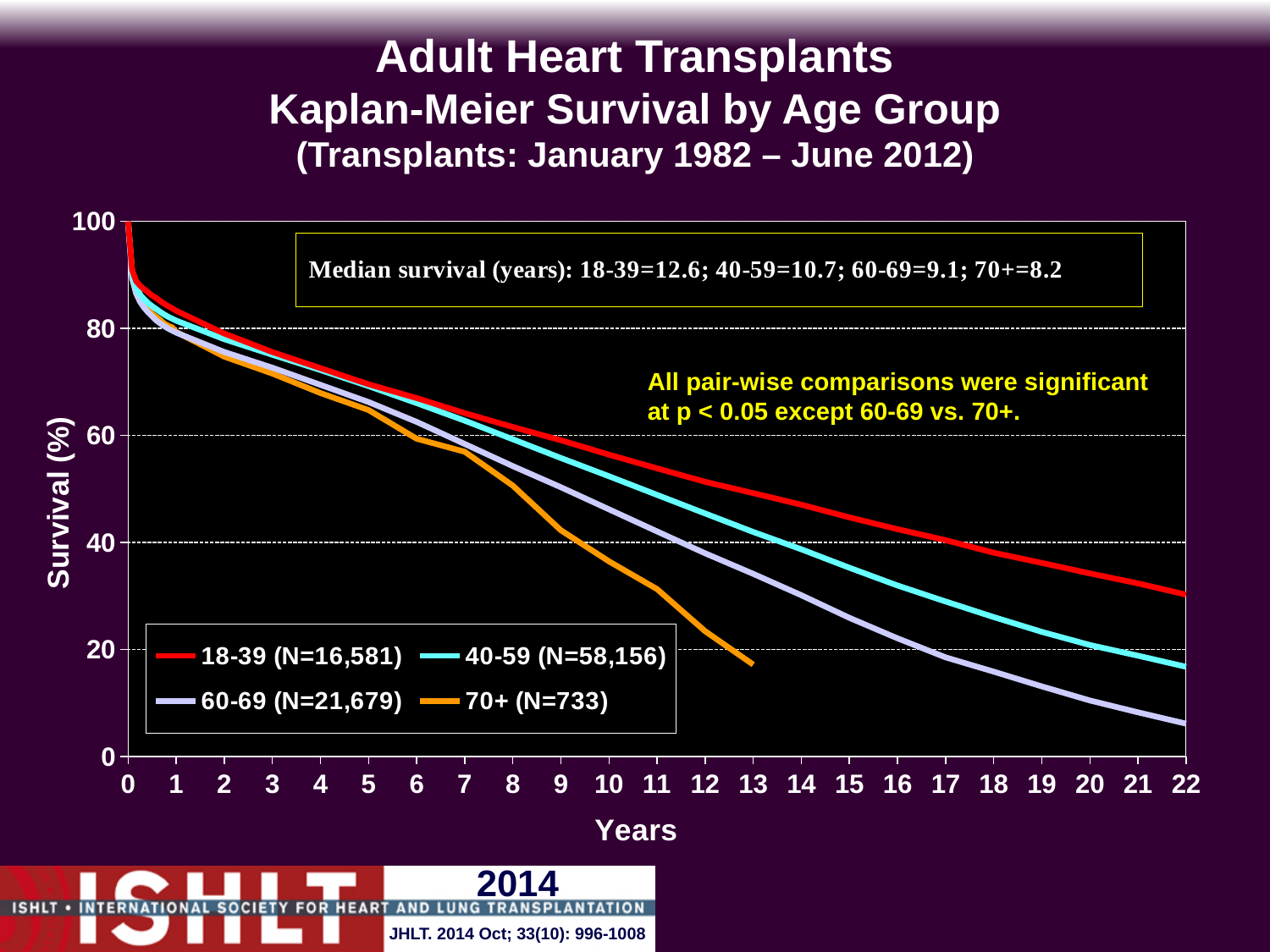
Do the survival curves rise or fall as years increase? fall Which age group has the highest median survival? 18-39 What is the median survival in years for the 70+ age group? 8.2 Which age group has the lowest median survival? 70+ Is the survival value for the 60-69 group at 22 years greater or less than 20? less At 10 years, which curve shows higher survival: 18-39 or 70+? 18-39 What is the N for the 40-59 age group shown in the legend? 58,156 How many age groups (series) does the legend list? 4 What is the median survival in years for the 18-39 age group? 12.6 What kind of chart is shown on the slide? line chart What is the label of the y axis? Survival (%) What is the difference in median survival (years) between the 18-39 and 70+ age groups? 4.4